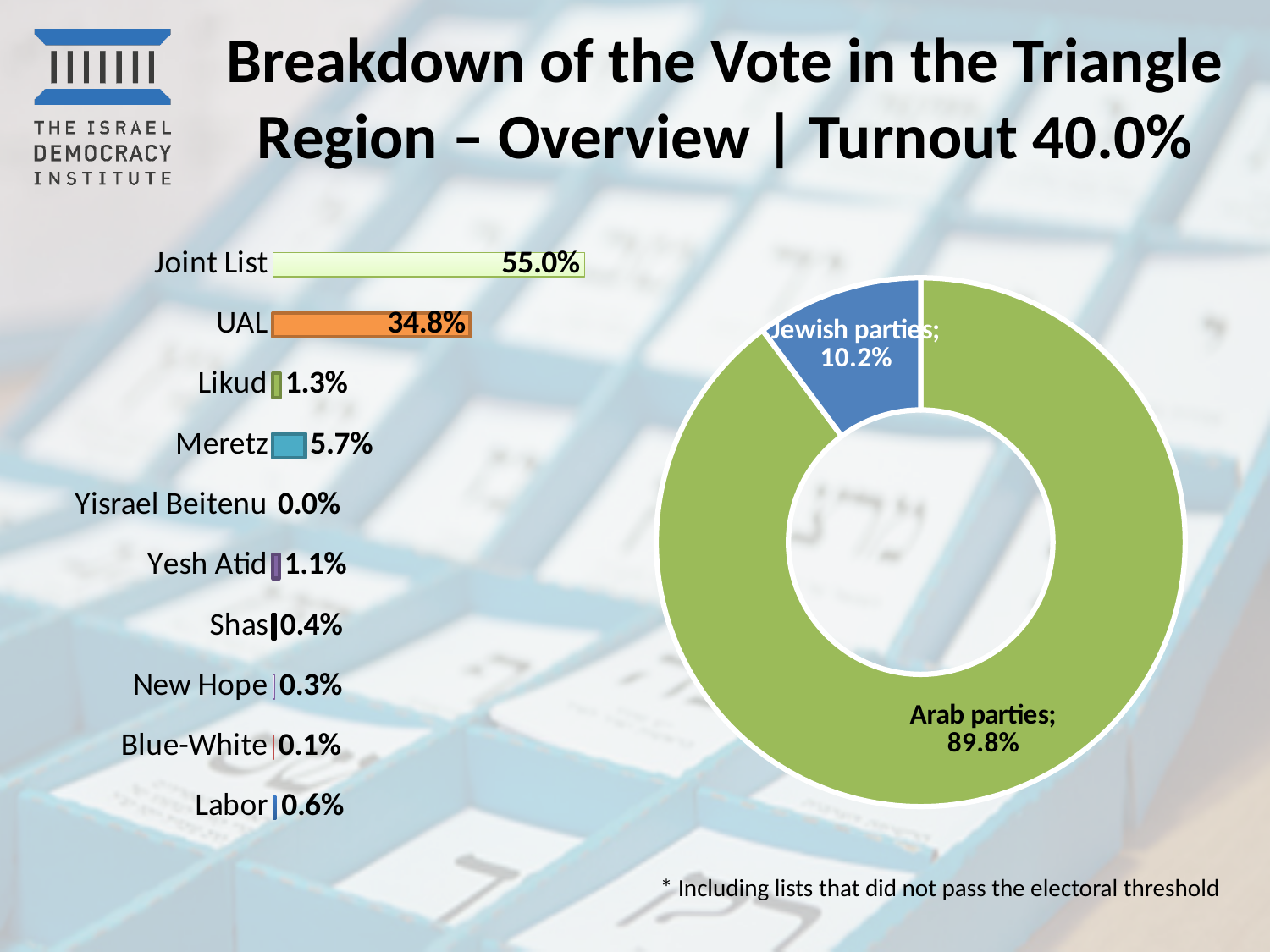
What kind of chart is on the left side of the slide? Bar chart How many parties are shown in the bar chart on the left? 10 What kind of chart is on the right side of the slide? Doughnut chart In the bar chart on the left, what is the value for UAL? 34.8% In the bar chart on the left, which party has the highest value? Joint List In the doughnut chart on the right, what share do Jewish parties have? 10.2% In the bar chart on the left, which party has the lowest value? Yisrael Beitenu In the bar chart on the left, what is the value for Meretz? 5.7% In the bar chart on the left, which is larger, the value for Likud or the value for Yesh Atid? Likud In the bar chart on the left, what is the difference between the values for Joint List and UAL? 20.2% In the doughnut chart on the right, what share do Arab parties have? 89.8% In the bar chart on the left, what is the value for Joint List? 55.0%